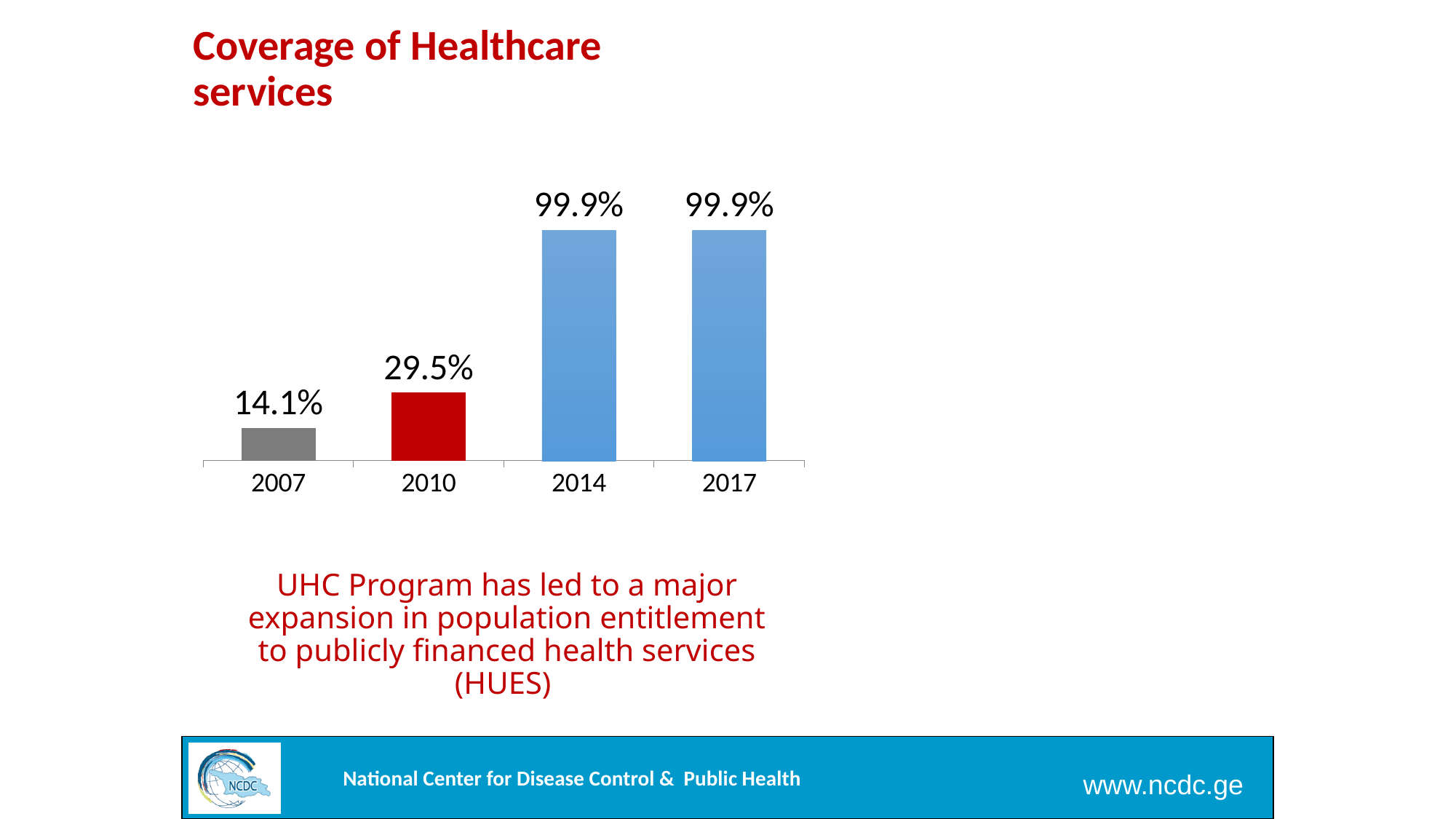
What colour is the bar for 2010? Red What is the difference between the coverage values for 2014 and 2010? 70.4% What is the coverage value shown for 2014? 99.9% Which is larger, the value for 2010 or the value for 2007? 2010 What is the difference between the coverage values for 2010 and 2007? 15.4% Which year has the lowest coverage value? 2007 What is the coverage value shown for 2010? 29.5% What is the coverage value shown for 2007? 14.1% How many years are shown on the x axis of the chart? 4 What kind of chart is shown on the slide? Bar chart Do the values rise or fall from 2007 to 2014? Rise What is the coverage value shown for 2017? 99.9%